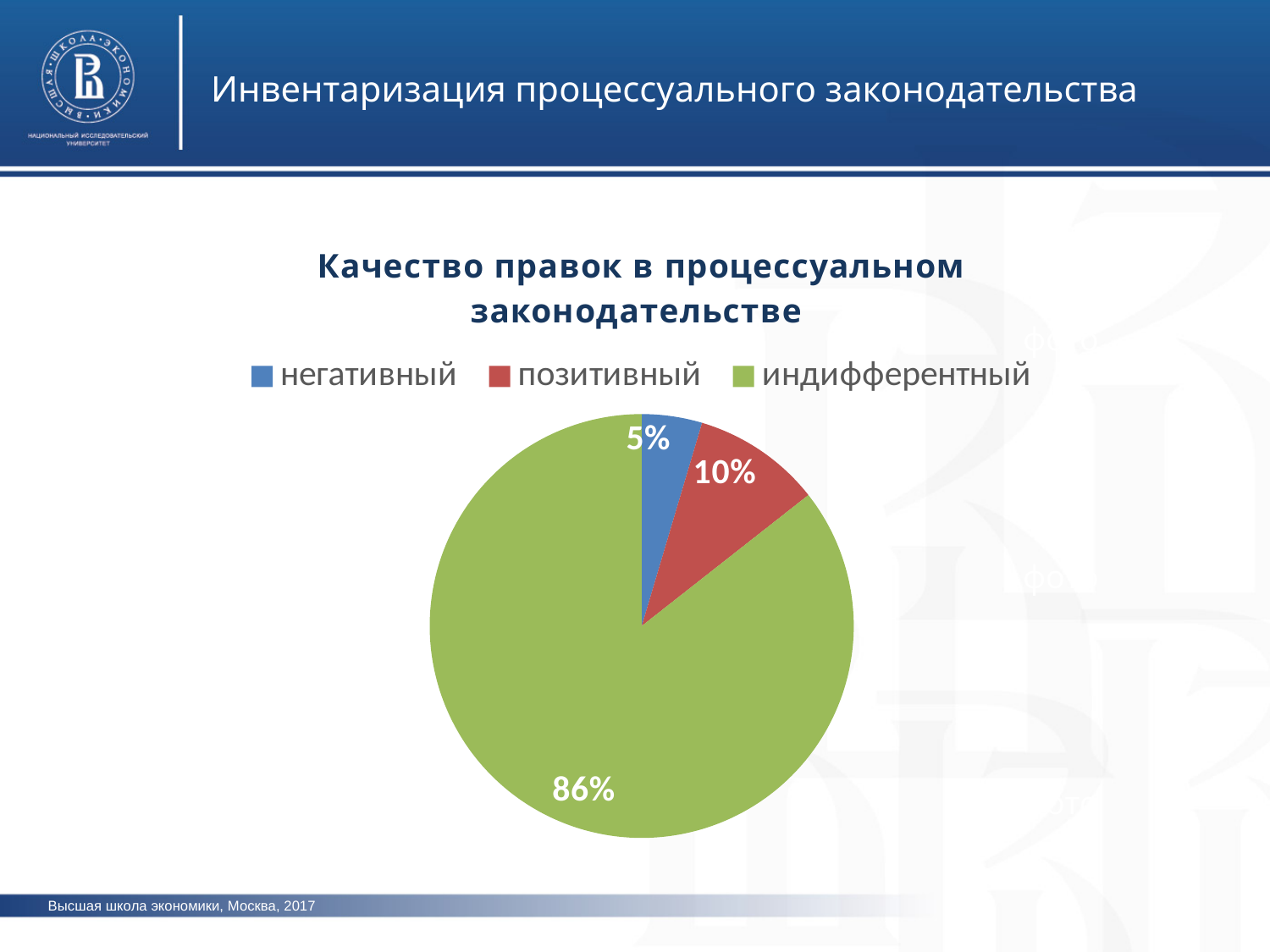
What is the title of the chart? Качество правок в процессуальном законодательстве What is the difference in percentage points between the 'индифферентный' and 'позитивный' slices? 76 What share of the pie does the 'негативный' slice represent? 5% What share of the pie does the 'индифферентный' slice represent? 86% How many entries does the legend list? 3 Which is larger, the 'позитивный' slice or the 'негативный' slice? позитивный What colour is the 'индифферентный' slice? green Which category has the smallest slice of the pie? негативный How many categories does the pie chart show? 3 What share of the pie does the 'позитивный' slice represent? 10% Which category has the largest slice of the pie? индифферентный What kind of chart is shown on the slide? pie chart